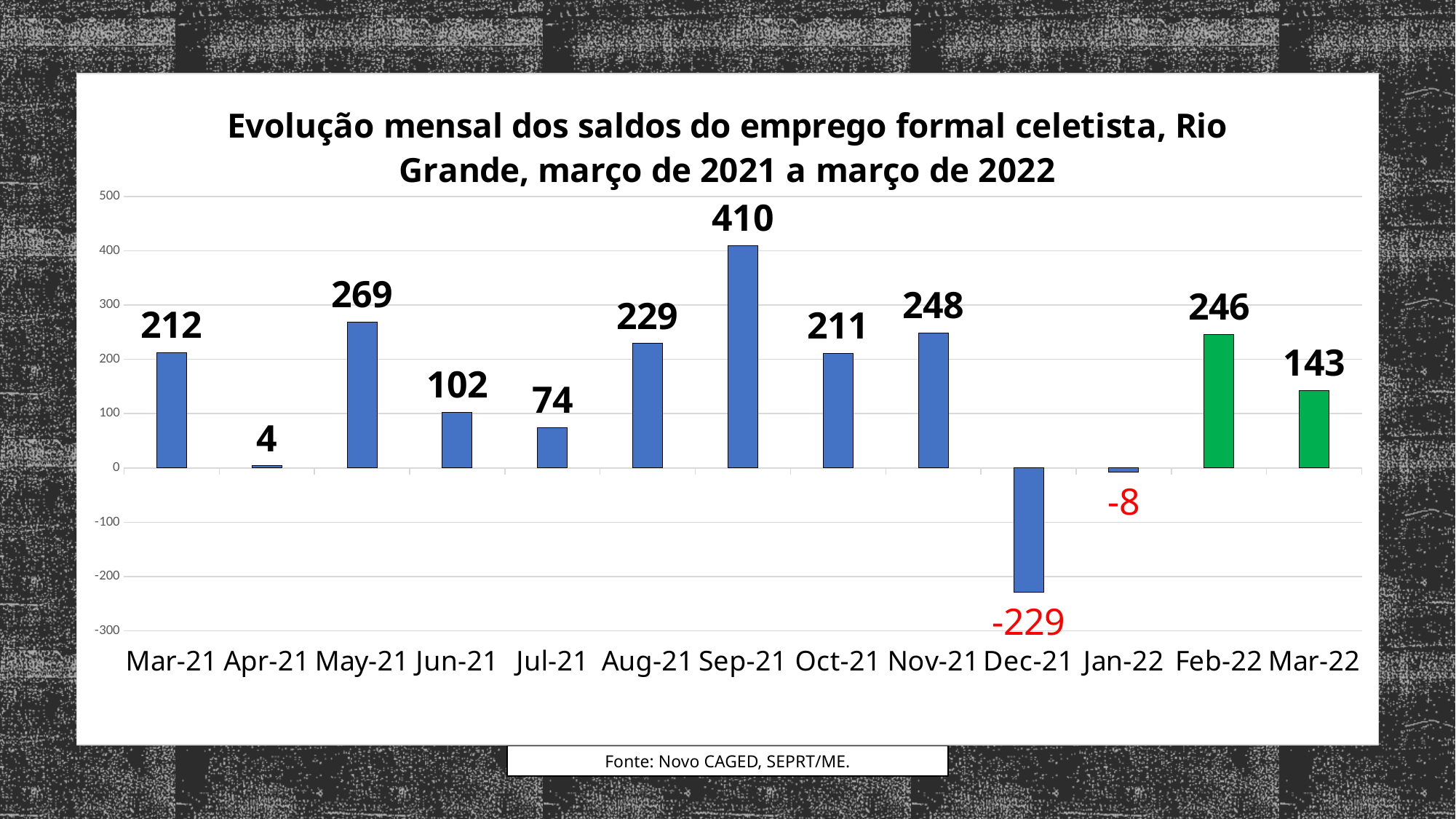
What kind of chart is shown on the slide? bar chart What is the value for Dec-21? -229 Which month has the highest value? Sep-21 How many months are shown on the x axis? 13 What is the value for Jan-22? -8 Do the values rise or fall from Sep-21 to Dec-21? fall Is the value for Nov-21 greater or less than 200? greater Which is larger, the value for Feb-22 or the value for Mar-22? Feb-22 What is the value for Sep-21? 410 What colour are the bars for Feb-22 and Mar-22? green Which month has the lowest value? Dec-21 What is the difference between the values for Sep-21 and May-21? 141